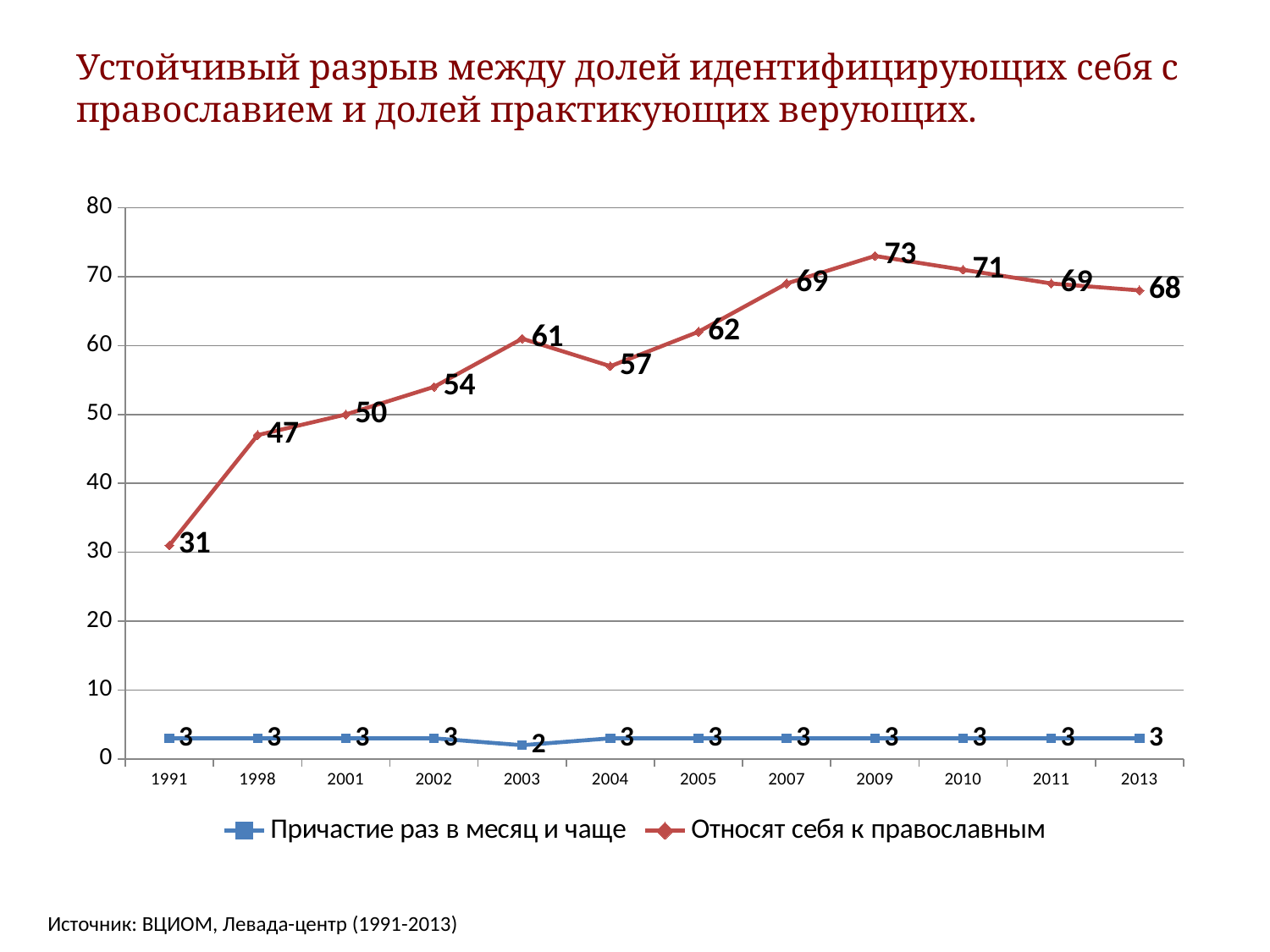
How many series does the legend list? 2 In which year does the series 'Относят себя к православным' have its lowest value? 1991 What value does the series 'Относят себя к православным' have in 2009? 73 Does the series 'Относят себя к православным' rise or fall between 1991 and 2009? rise What is the difference between the 'Относят себя к православным' values in 2013 and 1991? 37 What value does the series 'Причастие раз в месяц и чаще' have in 2003? 2 In which year does the series 'Относят себя к православным' reach its highest value? 2009 Which is larger: the 'Относят себя к православным' value in 2003 or in 2004? 2003 What value does the series 'Относят себя к православным' have in 1991? 31 What is the source cited below the chart? ВЦИОМ, Левада-центр (1991-2013) What kind of chart is shown on the slide? line chart How many years are shown on the x axis? 12